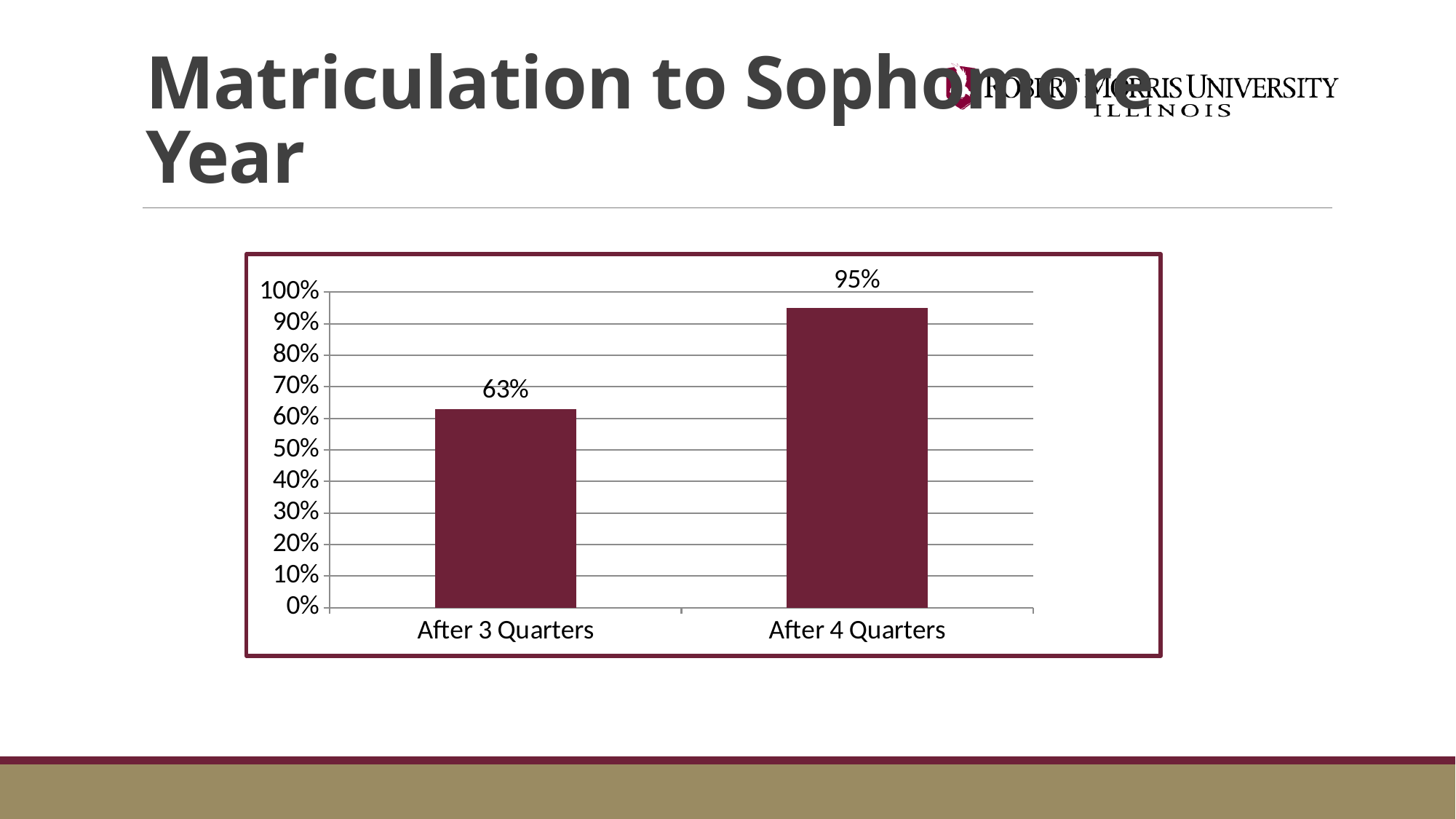
What is the value for After 3 Quarters? 63% Which category has the lowest value? After 3 Quarters Which category has the highest value? After 4 Quarters How many categories are shown on the x axis? 2 Is the value for After 4 Quarters greater or less than 90%? greater Is the value for After 3 Quarters greater or less than 70%? less What is the difference between the values for After 4 Quarters and After 3 Quarters? 32% Which is larger, the value for After 3 Quarters or After 4 Quarters? After 4 Quarters What is the value for After 4 Quarters? 95% What kind of chart is shown on the slide? bar chart What is the title of the slide containing the chart? Matriculation to Sophomore Year Do the values rise or fall from After 3 Quarters to After 4 Quarters? rise